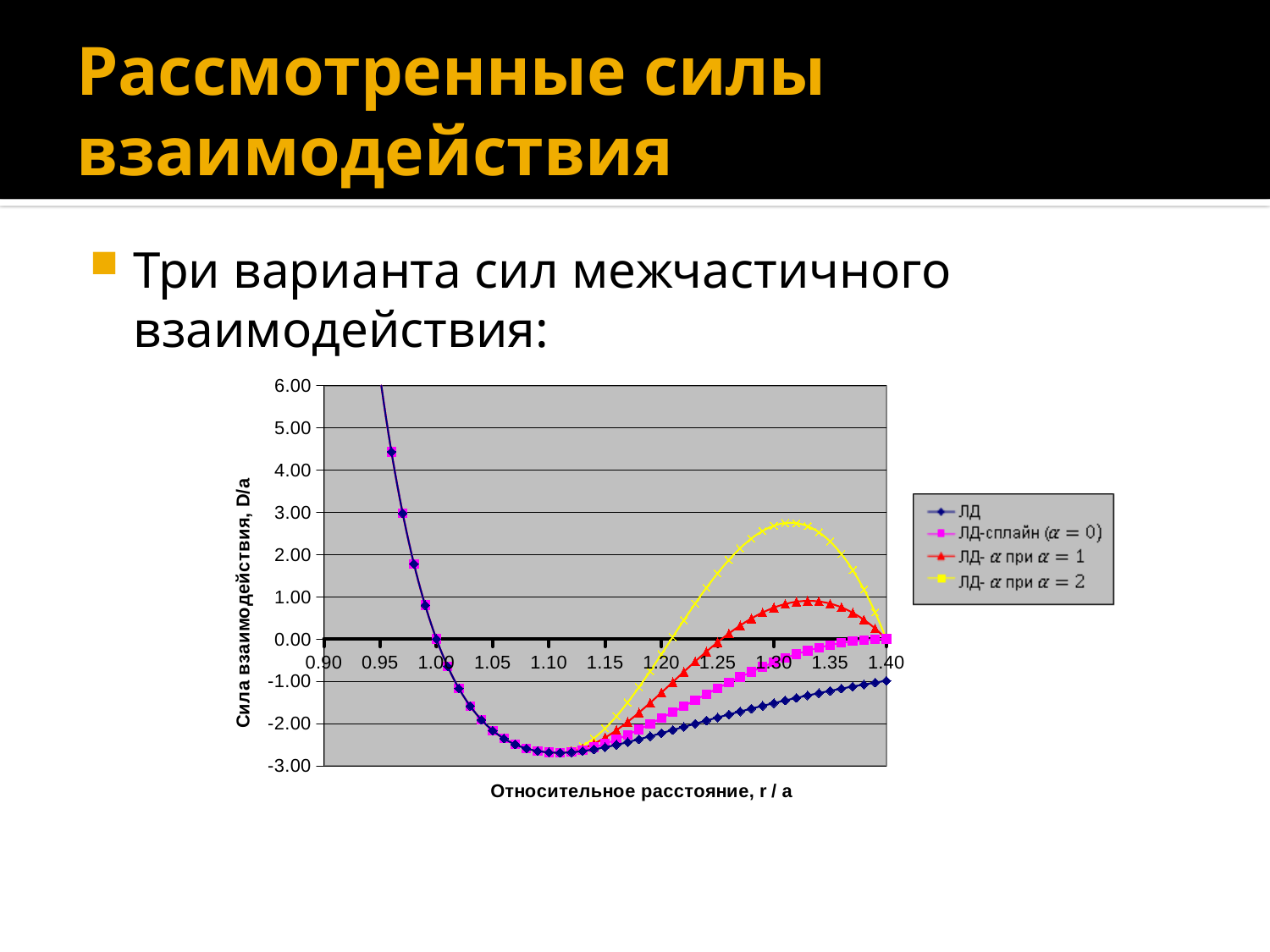
At x = 1.30, is the value for ЛД- α при α = 2 greater or less than 2.00? greater At x = 1.30, which series has the larger value: ЛД- α при α = 1 or ЛД- α при α = 2? ЛД- α при α = 2 At x = 1.30, is the value for ЛД greater or less than -1.00? less What kind of chart is shown on the slide? line chart Which series reaches the highest value in the range between 1.20 and 1.40 on the x axis? ЛД- α при α = 2 At x = 1.30, is the value for ЛД- α при α = 1 greater or less than 0.00? greater What is the title of the chart's x axis? Относительное расстояние, r / a How many series does the chart legend list? 4 Do the values of the ЛД series rise or fall as x increases from 1.10 to 1.40? rise What is the title of the chart's y axis? Сила взаимодействия, D/a How many tick labels are shown on the x axis? 11